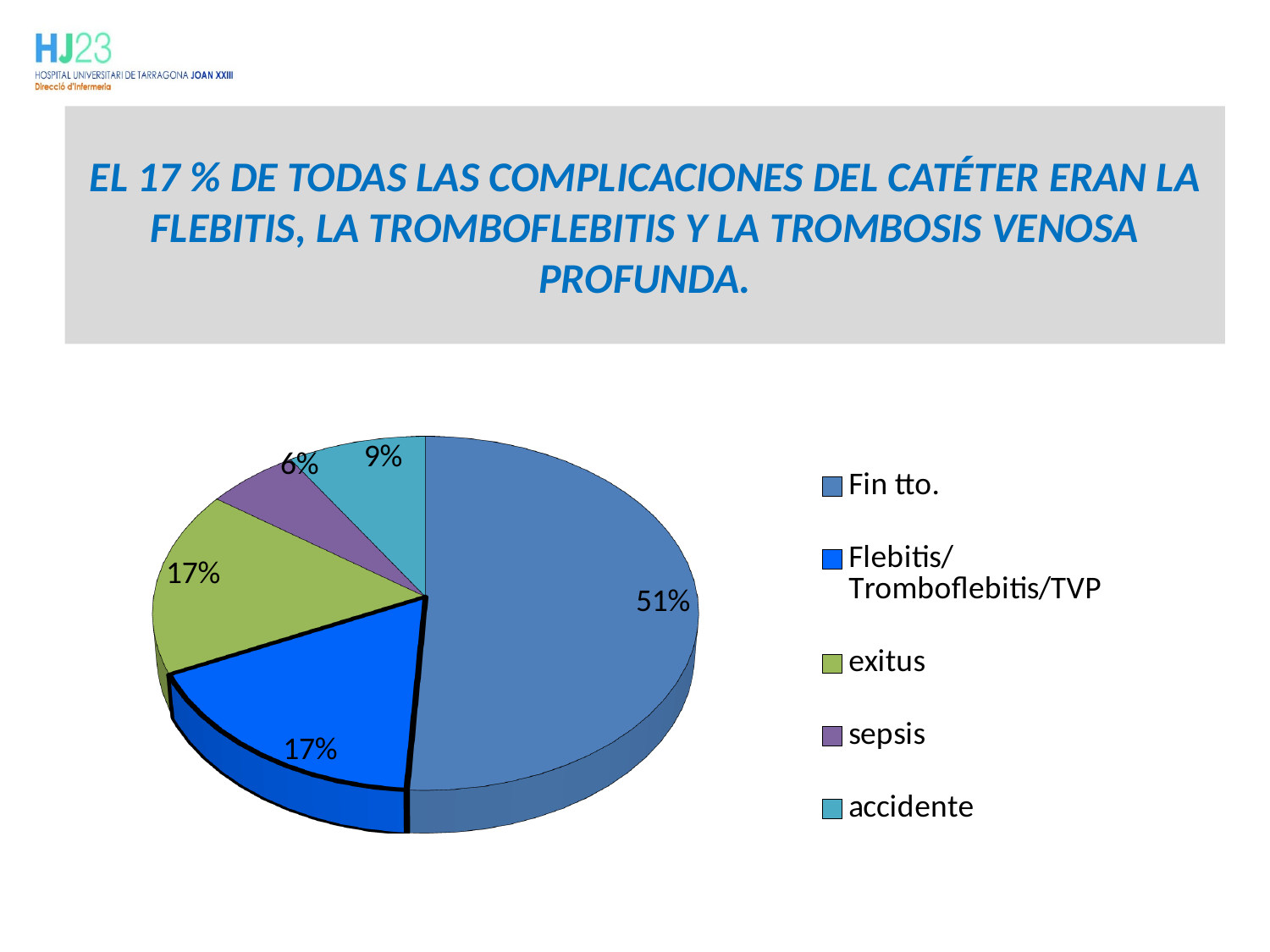
Which category has the smallest slice of the pie? sepsis Which legend entry is shown in green? exitus What type of chart is shown on the slide? pie chart Which category has the largest slice of the pie? Fin tto. What percentage is shown for the "sepsis" slice? 6% What percentage is shown for the "accidente" slice? 9% Which is larger, the "accidente" slice or the "sepsis" slice? accidente What percentage is shown for the "Flebitis/Tromboflebitis/TVP" slice? 17% What is the difference in percentage points between the "Fin tto." slice and the "accidente" slice? 42 How many categories does the pie chart show? 5 What share of the pie does the "Fin tto." slice represent? 51% What percentage is shown for the "exitus" slice? 17%